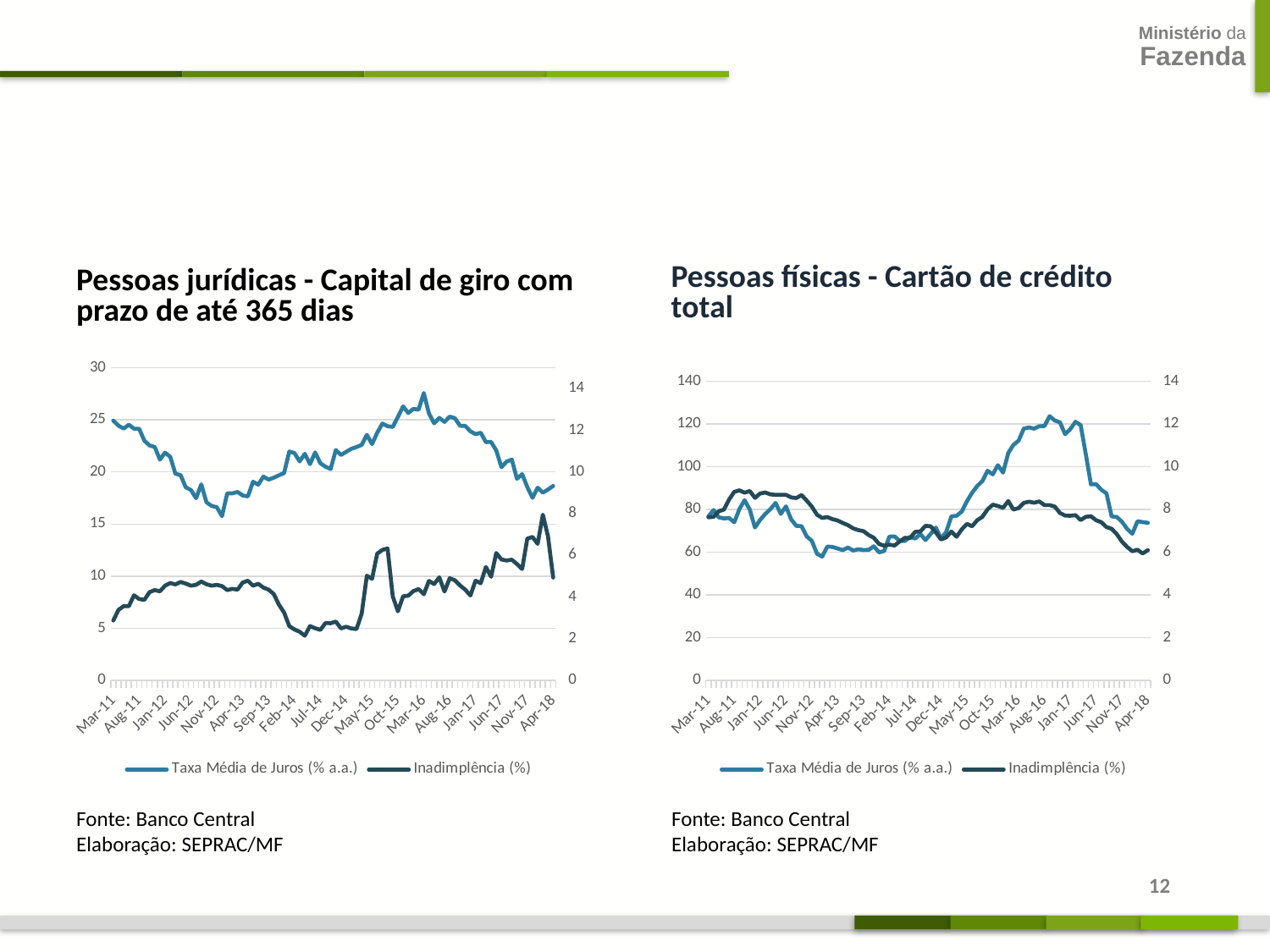
What kind of chart is the 'Pessoas jurídicas - Capital de giro com prazo de até 365 dias' chart? line chart How many series does the legend of the 'Pessoas físicas - Cartão de crédito total' chart list? 2 In the 'Pessoas físicas - Cartão de crédito total' chart, what are the two series named in the legend? Taxa Média de Juros (% a.a.) and Inadimplência (%) What kind of chart is the 'Pessoas físicas - Cartão de crédito total' chart? line chart In the 'Pessoas físicas - Cartão de crédito total' chart, is the value of Taxa Média de Juros (% a.a.) at Mar-11 greater or less than 100? less In the 'Pessoas jurídicas - Capital de giro com prazo de até 365 dias' chart, does Taxa Média de Juros (% a.a.) rise or fall between Mar-11 and Nov-12? fall In the 'Pessoas físicas - Cartão de crédito total' chart, is the value of Taxa Média de Juros (% a.a.) at Aug-16 greater or less than 100? greater In the 'Pessoas físicas - Cartão de crédito total' chart, does Taxa Média de Juros (% a.a.) rise or fall between Jan-17 and Apr-18? fall In the 'Pessoas jurídicas - Capital de giro com prazo de até 365 dias' chart, is the value of Taxa Média de Juros (% a.a.) at Mar-11 greater or less than 20? greater How many series does the legend of the 'Pessoas jurídicas - Capital de giro com prazo de até 365 dias' chart list? 2 In the 'Pessoas jurídicas - Capital de giro com prazo de até 365 dias' chart, what is the maximum value shown on the left vertical axis? 30